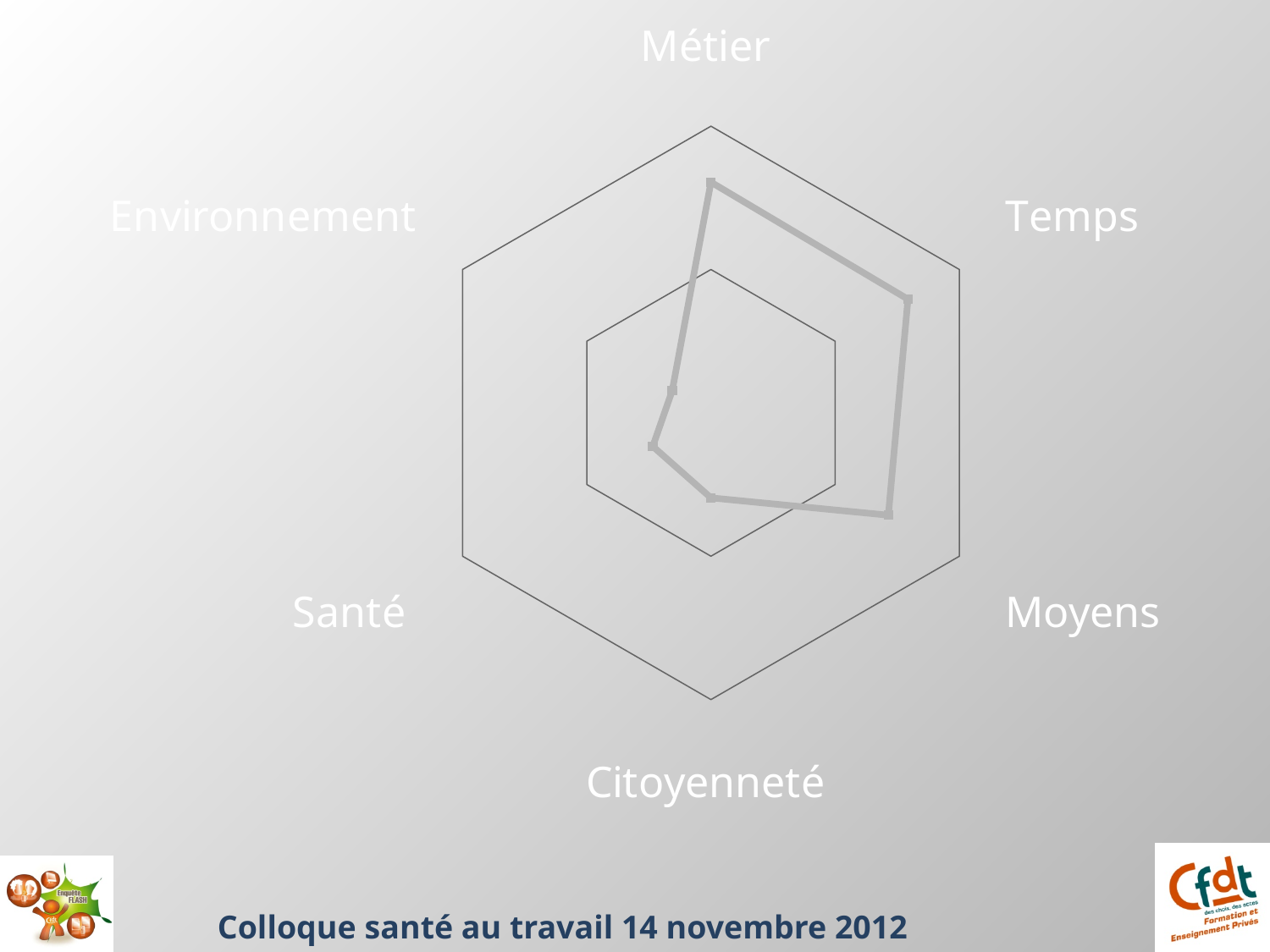
Which is larger, the value for Moyens or the value for Environnement? Moyens Which category label appears at the bottom of the radar chart? Citoyenneté Which category has the lowest value on the radar chart? Environnement Which is larger, the value for Citoyenneté or the value for Environnement? Citoyenneté Which is larger, the value for Métier or the value for Santé? Métier How many categories (axes) does the radar chart have? 6 What kind of chart is shown on the slide? Radar chart Which category label appears at the top of the radar chart? Métier